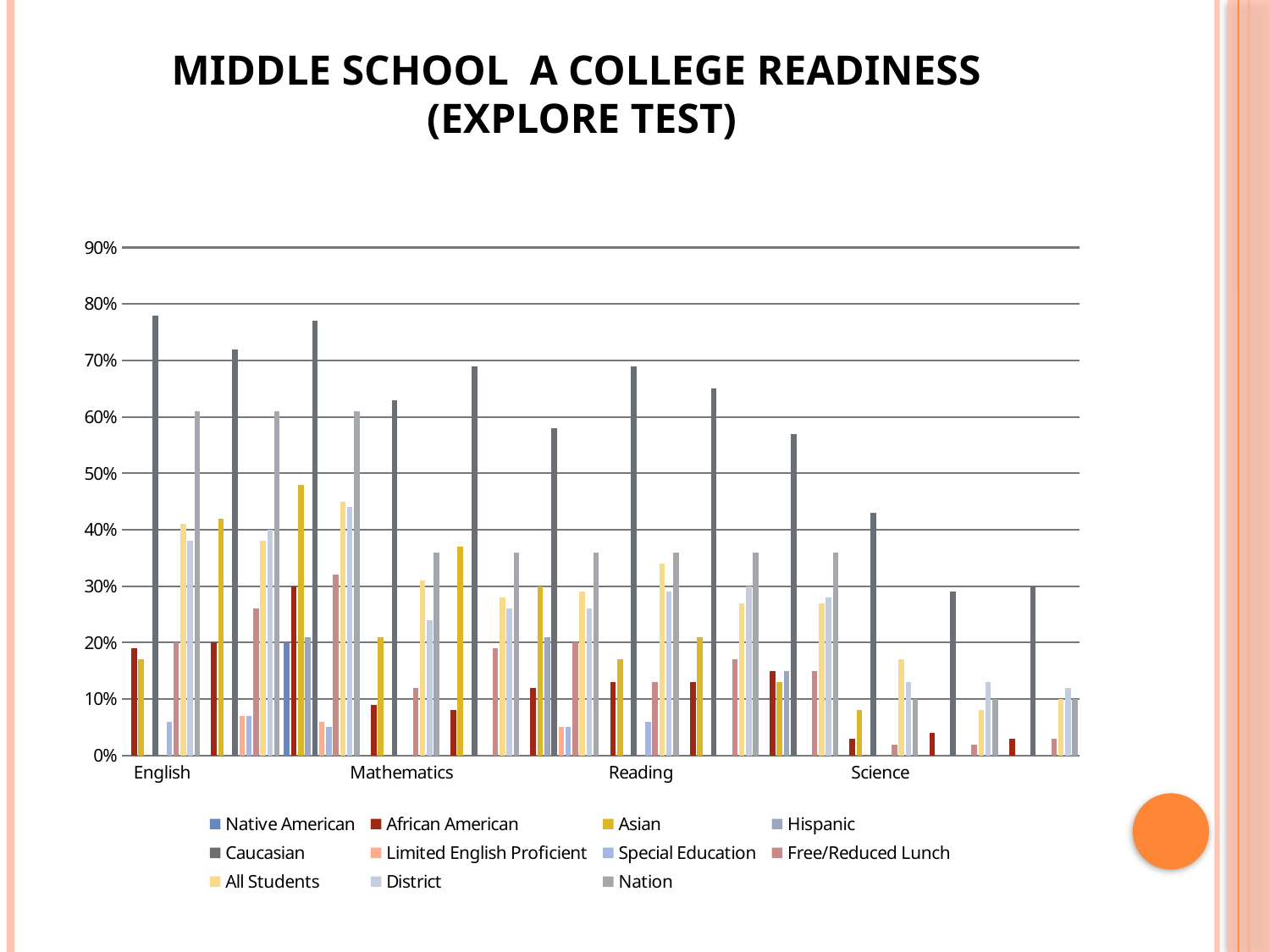
Which series has the tallest bar anywhere on the chart? Caucasian What is the highest value shown on the y axis? 90% Is the value of the first Asian bar in the English group greater or less than 30%? less Is the value of the first Caucasian bar in the Reading group greater or less than 60%? greater How many series does the legend list? 11 Is the value of the first Caucasian bar in the Science group greater or less than 50%? less What kind of chart is shown on the slide? bar chart What is the title of the chart? MIDDLE SCHOOL A COLLEGE READINESS (EXPLORE TEST) How many subject labels appear on the x axis? 4 In the first English cluster, which is larger: the Caucasian bar or the African American bar? Caucasian